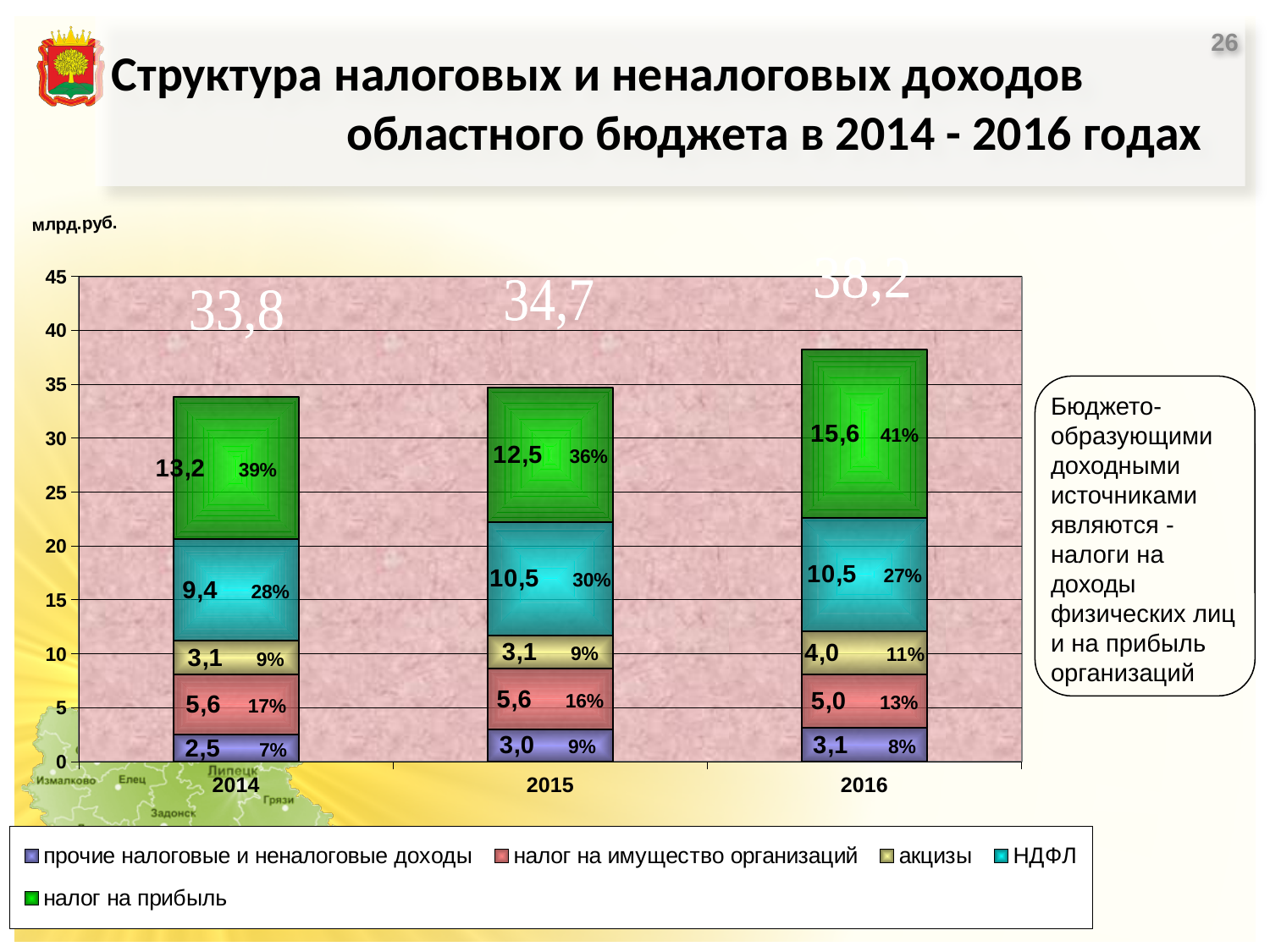
What is the value of налог на прибыль in 2016? 15,6 Does the total for 2014 rise or fall by 2016? rise What is the total of the stacked bar for 2015? 34,7 What percentage share does акцизы have in 2016? 11% What type of chart is shown on the slide? stacked bar chart In which year is the total of the stacked bar the highest? 2016 How many series does the legend list? 5 What is the difference between налог на прибыль in 2016 and in 2015? 3,1 How many years (categories) are shown on the x axis? 3 Which series has the lowest value in 2014? прочие налоговые и неналоговые доходы Which is larger in 2016: налог на имущество организаций or акцизы? налог на имущество организаций What is the value of НДФЛ in 2014? 9,4